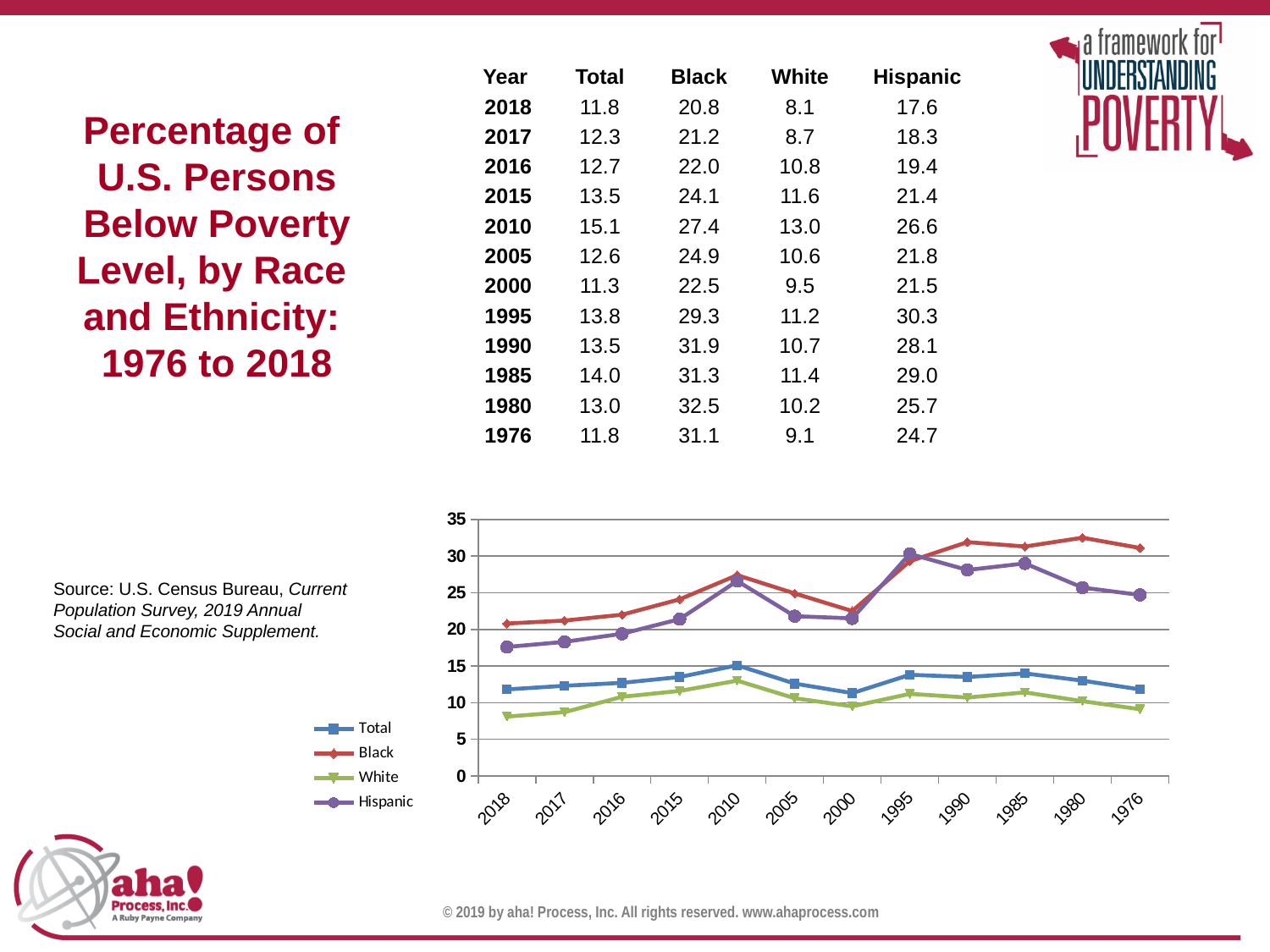
In which year is the White series at its lowest value? 2018 What is the poverty percentage for Hispanic persons in 1995? 30.3 How many years are plotted along the x axis of the chart? 12 What is the difference between the Black and White values in 2018? 12.7 Does the Total series rise or fall from 2018 to 2010 along the x axis? rise What colour is the Hispanic line in the chart? purple What is the poverty percentage for Black persons in 2018? 20.8 Is the value for Black persons in 2010 greater or less than 25? greater How many series does the chart's legend list? 4 What kind of chart is shown on the slide? line chart In 1995, which is larger: the Hispanic value or the Black value? Hispanic In which year is the Black series at its highest value? 1980